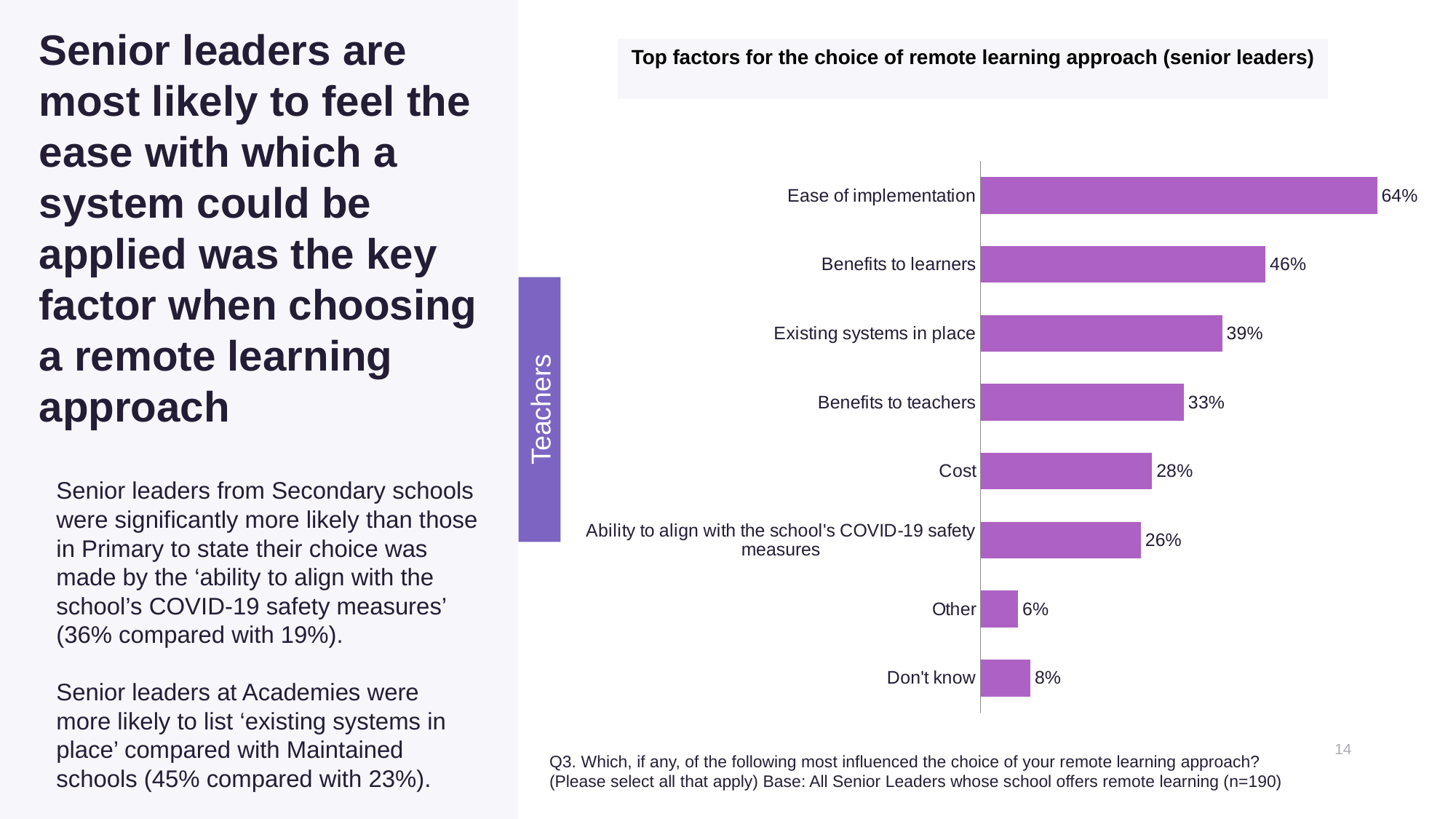
What is the value shown for 'Benefits to learners'? 46% Which is larger, 'Other' or 'Don't know'? Don't know Which factor has the highest percentage in the chart? Ease of implementation What is the difference between 'Ease of implementation' and 'Benefits to learners'? 18 percentage points What percentage is shown for 'Ability to align with the school's COVID-19 safety measures'? 26% How many categories are shown in the chart? 8 Which category has the lowest percentage in the chart? Other What percentage of senior leaders chose 'Ease of implementation' as a top factor? 64% What is the difference between 'Existing systems in place' and 'Cost'? 11 percentage points What is the title of the chart? Top factors for the choice of remote learning approach (senior leaders) What type of chart is shown on the slide? Bar chart Which is larger, 'Benefits to teachers' or 'Cost'? Benefits to teachers